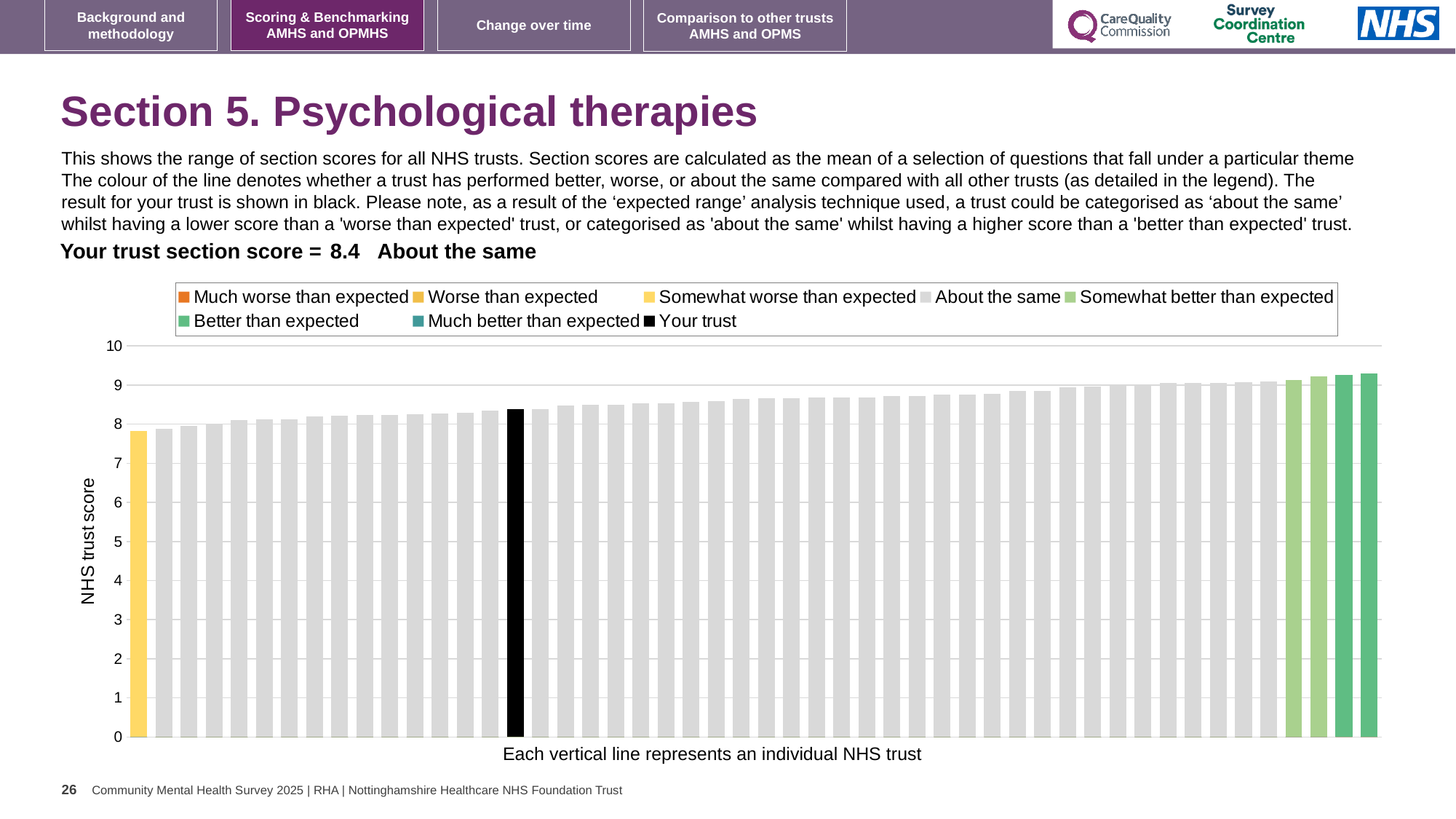
Is the value of the black 'Your trust' bar greater or less than 8? greater Is the value of the shortest bar on the chart greater or less than 7? greater Which category is your trust placed in according to the slide? About the same What kind of chart is shown on the slide? bar chart Do the bar values rise or fall from left to right along the x axis? rise Is the value of the tallest bar on the chart greater or less than 9? greater How many bars are coloured as 'Better than expected' (darker green)? 2 How many entries does the chart legend list? 8 What is the section score for your trust shown on the slide? 8.4 How many bars are coloured as 'Worse than expected' (yellow)? 0 What is the label on the vertical axis of the chart? NHS trust score